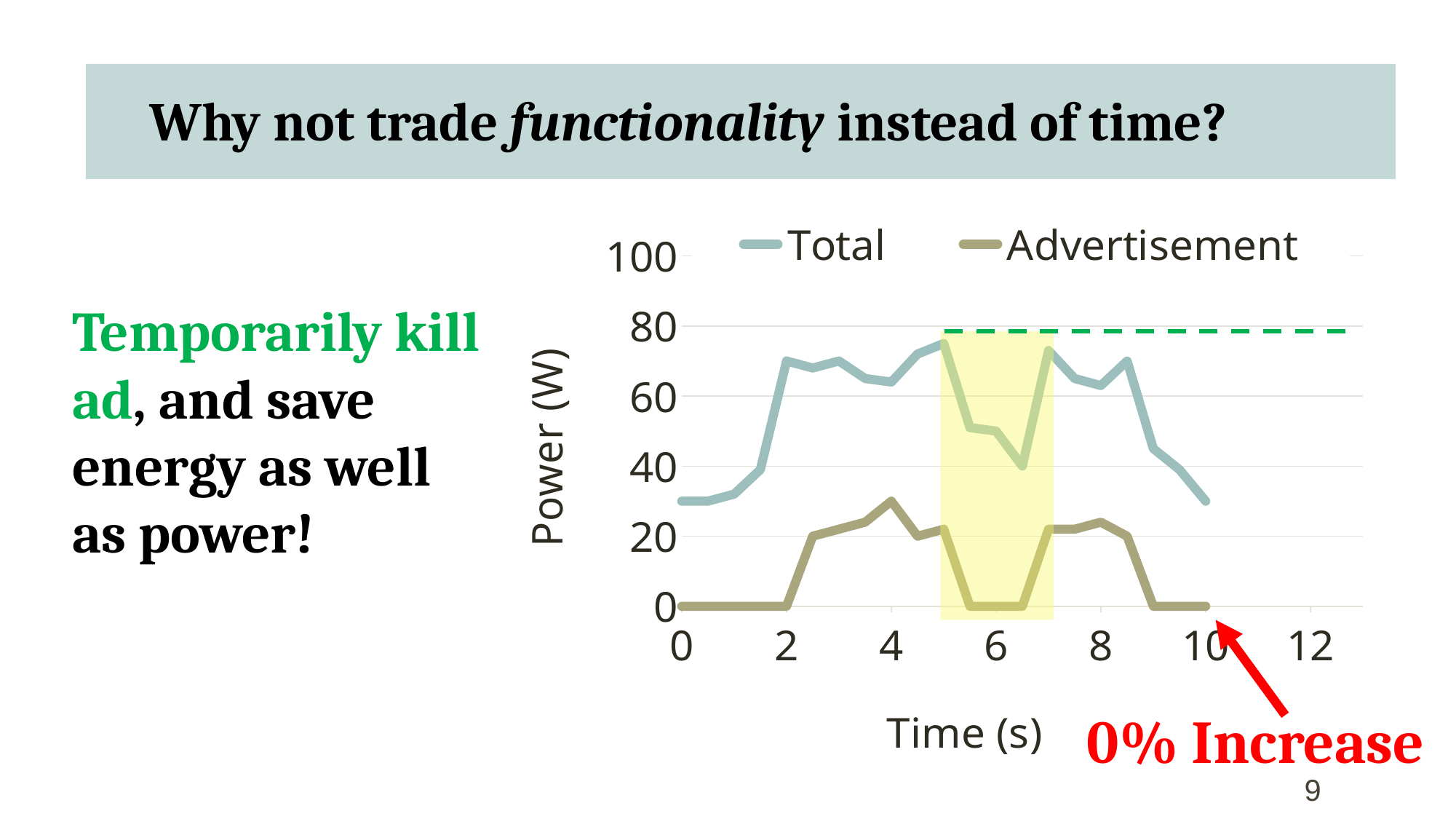
What kind of chart is shown on the slide? line chart Is the Total value at time 6 s greater or less than 60? less How many series does the chart's legend list? 2 What is the Advertisement value at time 10 s? 0 Is the Advertisement value at time 4 s greater or less than 20? greater What are the two series named in the chart's legend? Total and Advertisement Does the Total series rise or fall between time 8.5 s and 10 s? fall Is the Total value at time 2 s greater or less than 60? greater At time 4 s, which series has the larger value, Total or Advertisement? Total What is the Advertisement value at time 0 s? 0 What is the label of the chart's y axis? Power (W)